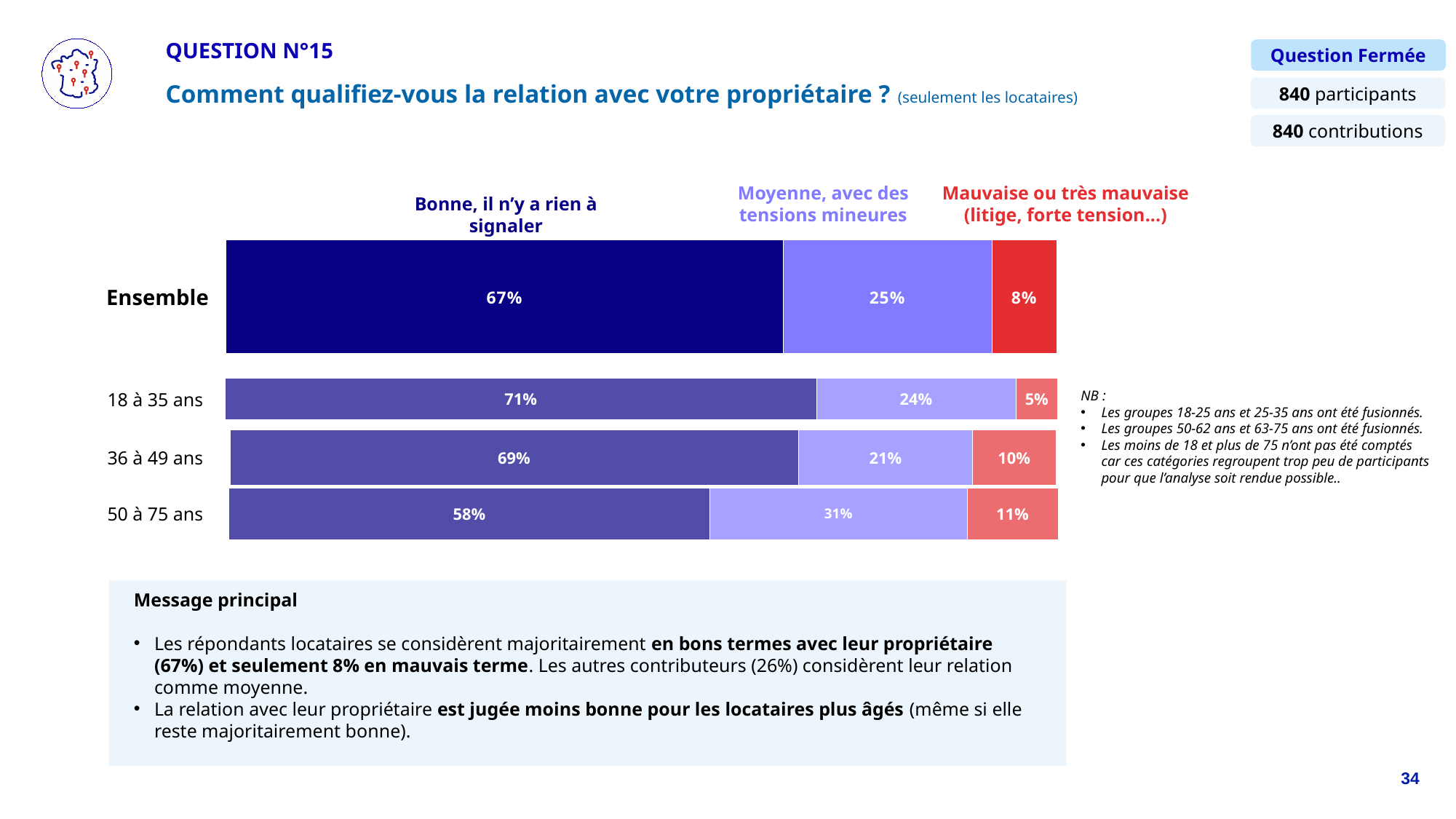
What is the 'Moyenne, avec des tensions mineures' value for the '50 à 75 ans' group? 31% What is the 'Mauvaise ou très mauvaise' share for the '36 à 49 ans' group? 10% Which age group has the highest 'Bonne, il n'y a rien à signaler' share? 18 à 35 ans How many response categories (series) does the chart show? 3 What is the difference between the 'Bonne' share of the '18 à 35 ans' group and that of the '50 à 75 ans' group? 13 percentage points What type of chart is shown on the slide? Stacked bar chart What is the total of the three segments in the 'Ensemble' bar? 100% How many bars (rows) are shown in the chart? 4 Which age group has the lowest 'Mauvaise ou très mauvaise' share? 18 à 35 ans What percentage of the 'Ensemble' group describes the relationship with their landlord as 'Bonne, il n'y a rien à signaler'? 67% Which colour represents the 'Mauvaise ou très mauvaise (litige, forte tension...)' category? Red Which is larger: the 'Moyenne' share for '36 à 49 ans' or for '18 à 35 ans'? 18 à 35 ans